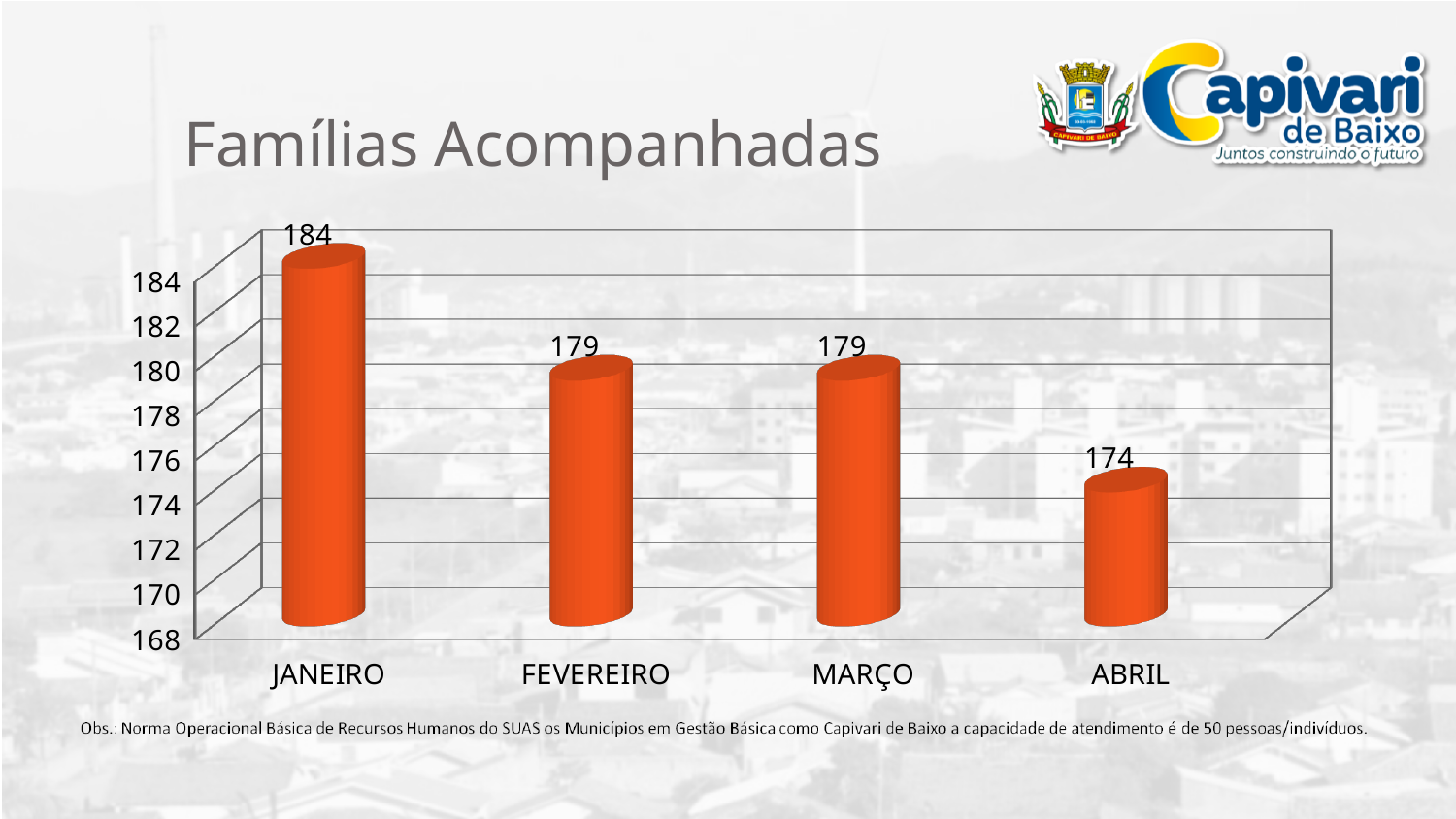
What is the difference between the values for JANEIRO and ABRIL? 10 Which month has the highest value? JANEIRO What is the difference between the values for FEVEREIRO and ABRIL? 5 What is the title of the chart? Famílias Acompanhadas Is the value for ABRIL greater or less than 176? less How many months are shown on the chart? 4 Which is larger, the value for MARÇO or the value for ABRIL? MARÇO Which month has the lowest value? ABRIL What is the value for ABRIL? 174 What is the value for FEVEREIRO? 179 What is the value for JANEIRO? 184 What kind of chart is shown on the slide? bar chart